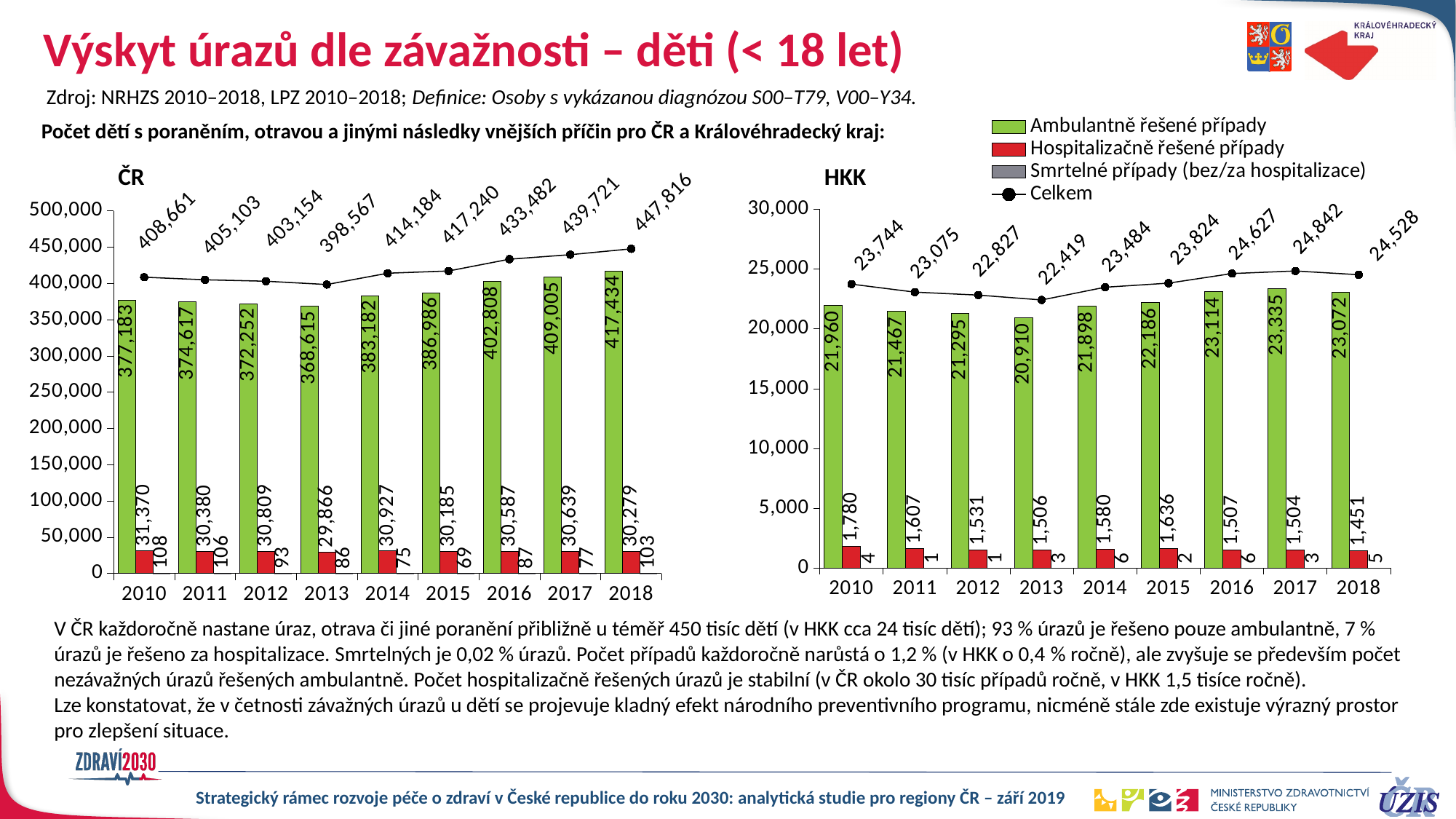
How many series does the legend list? 4 How many years are shown on the x axis of the ČR chart? 9 In the HKK chart, which year has the lowest Ambulantně řešené případy value? 2013 In the ČR chart, what is the difference between the Celkem values for 2018 and 2010? 39,155 In the ČR chart, what is the value of Ambulantně řešené případy in 2018? 417,434 In the HKK chart, what is the value of Hospitalizačně řešené případy in 2010? 1,780 In the HKK chart, which is larger: the Celkem value for 2017 or for 2018? 2017 In the HKK chart, what is the Smrtelné případy value for 2014? 6 In the ČR chart, which year has the highest Celkem value? 2018 What kind of chart is the HKK chart? Bar chart with a line In the HKK chart, what is the difference between the Ambulantně řešené případy values for 2017 and 2013? 2,425 In the ČR chart, what is the Celkem value for 2013? 398,567